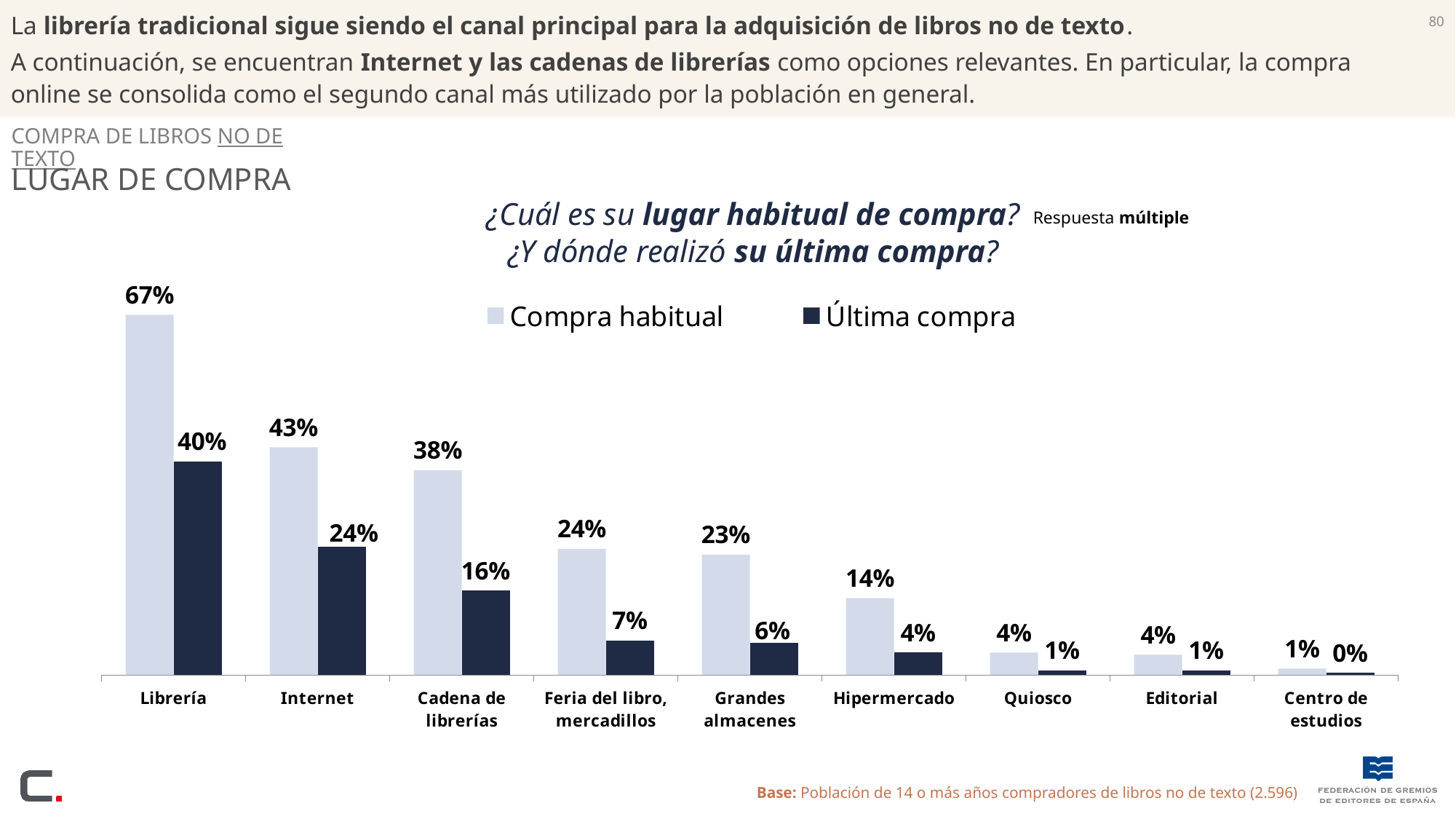
What is the 'Compra habitual' value for Hipermercado? 14% Which category has the highest 'Última compra' value? Librería What are the two series named in the legend? Compra habitual and Última compra How many categories are shown on the x axis? 9 What kind of chart is shown on the slide? Bar chart What is the 'Última compra' value for Internet? 24% Do the 'Compra habitual' values rise or fall from left to right along the x axis? Fall What is the difference between the 'Compra habitual' and 'Última compra' values for Cadena de librerías? 22% How many series does the legend list? 2 Which is larger: the 'Compra habitual' value for Internet or for Cadena de librerías? Internet Which category has the lowest 'Compra habitual' value? Centro de estudios What is the 'Compra habitual' value for Librería? 67%